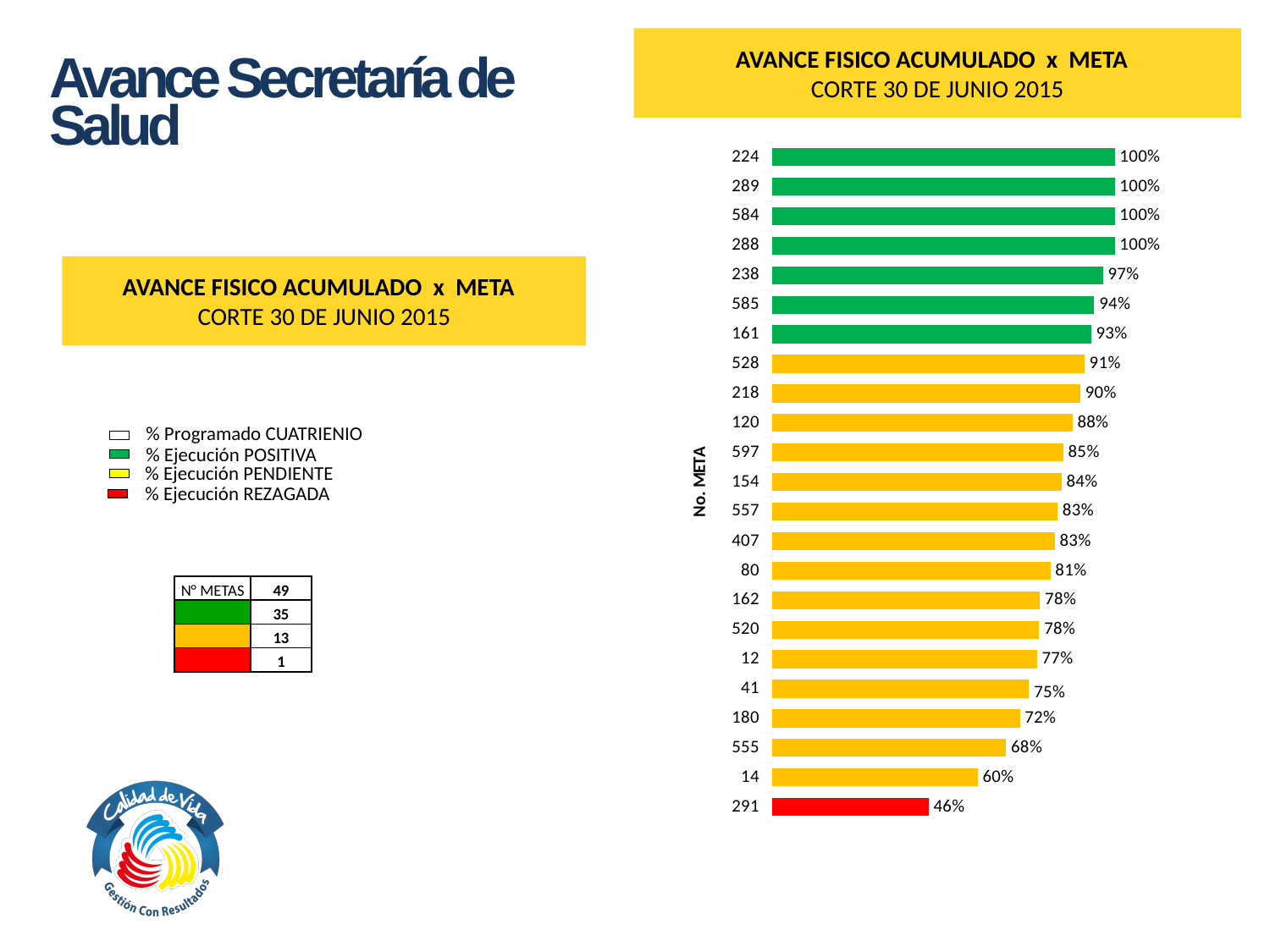
What is the value for meta 120? 88% What is the value for meta 14? 60% How many metas have a value of 100%? 4 What is the label of the vertical axis of the chart? No. META What kind of chart is shown on the slide? bar chart Which meta has the lowest value in the chart? 291 What is the difference between the values for meta 585 and meta 555? 26% What is the value for meta 291? 46% What colour is the bar for meta 291? red How many metas (bars) are shown in the chart? 23 What is the value for meta 238? 97% Which has a larger value, meta 528 or meta 180? 528